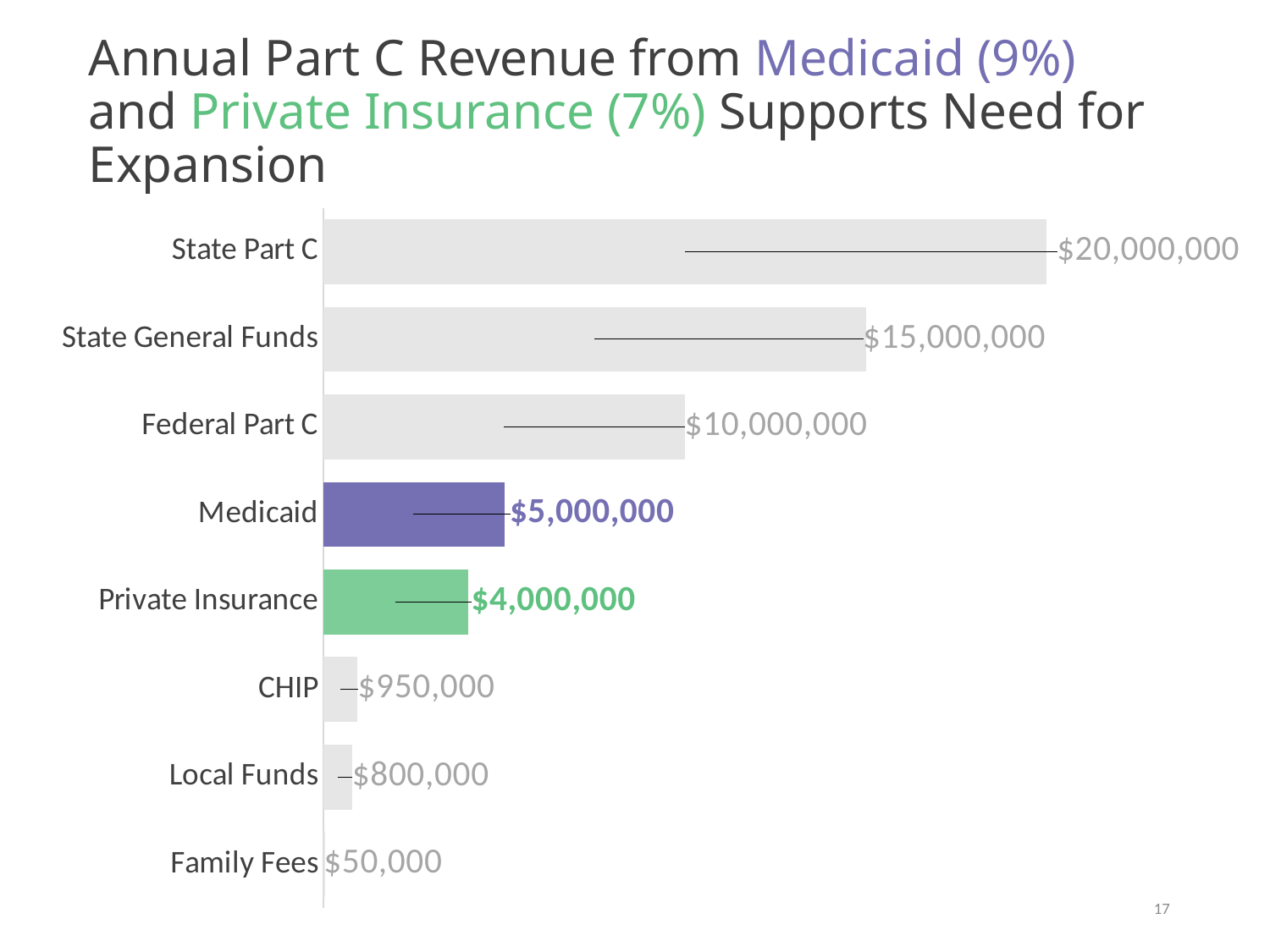
Which category has the highest value? State Part C Which is larger, Medicaid or Private Insurance? Medicaid What is the difference between State General Funds and Federal Part C? $5,000,000 What is the value for Private Insurance? $4,000,000 What is the value for Medicaid? $5,000,000 Which category has the lowest value? Family Fees What kind of chart is this? Bar chart How many categories are shown in the chart? 8 What is the value for CHIP? $950,000 What is the difference between CHIP and Local Funds? $150,000 What is the value for Family Fees? $50,000 What is the value for State Part C? $20,000,000